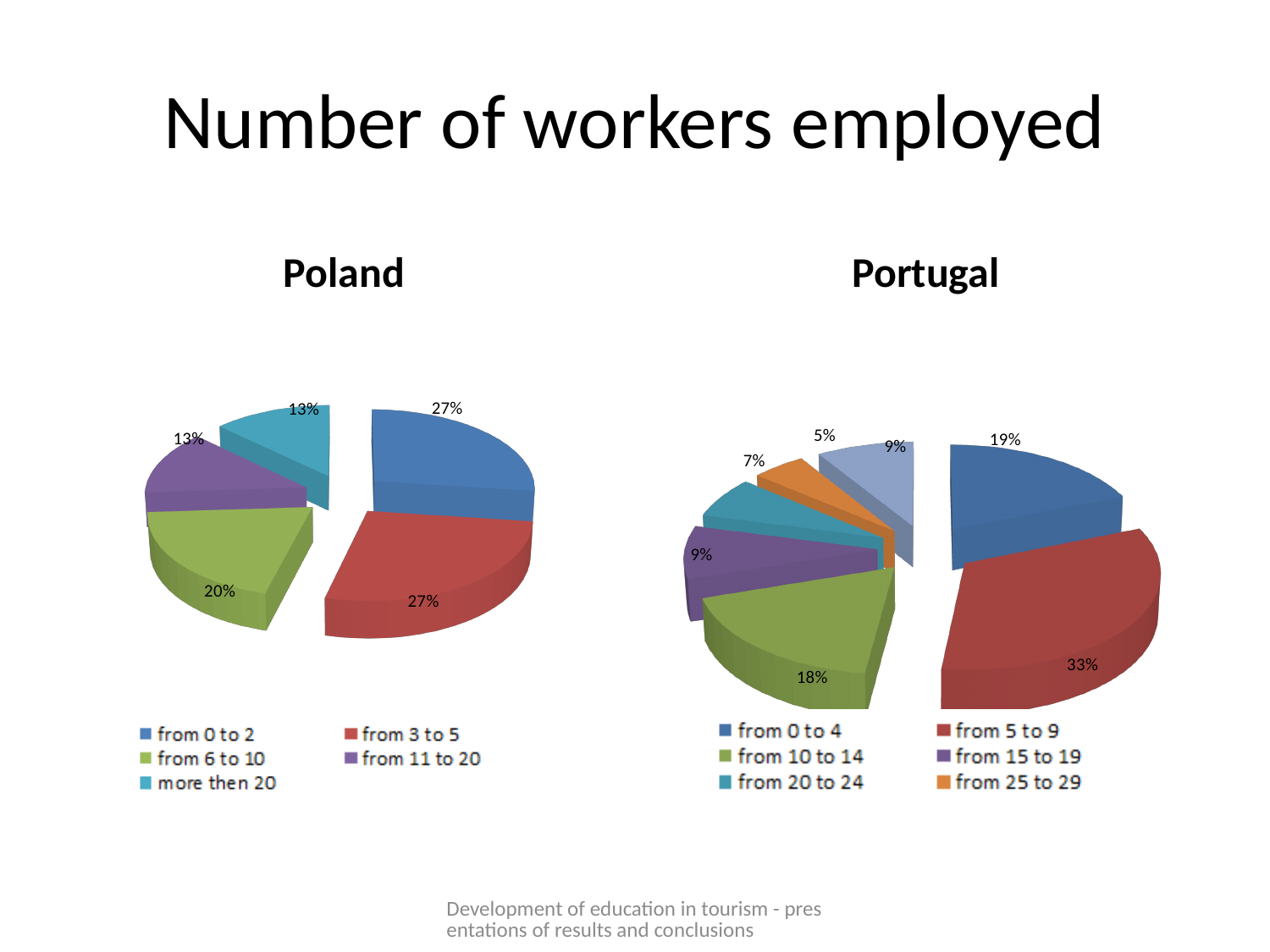
In the Poland chart, what share of the pie is 'from 6 to 10'? 20% How many categories does the Portugal chart's legend list? 6 In the Poland chart, what is the difference in percentage points between 'from 3 to 5' and 'from 6 to 10'? 7 percentage points What kind of chart is used for Poland? Pie chart In the Poland chart, what share of the pie is 'from 0 to 2'? 27% In the Portugal chart, what share of the pie is 'from 5 to 9'? 33% How many categories does the Poland chart's legend list? 5 In the Portugal chart, what share of the pie is 'from 20 to 24'? 7% In the Portugal chart, which category has the largest share? from 5 to 9 In the Poland chart, which is larger, 'from 6 to 10' or 'from 11 to 20'? from 6 to 10 In the Portugal chart, which legend category has the smallest share? from 25 to 29 In the Portugal chart, what is the difference in percentage points between 'from 5 to 9' and 'from 0 to 4'? 14 percentage points